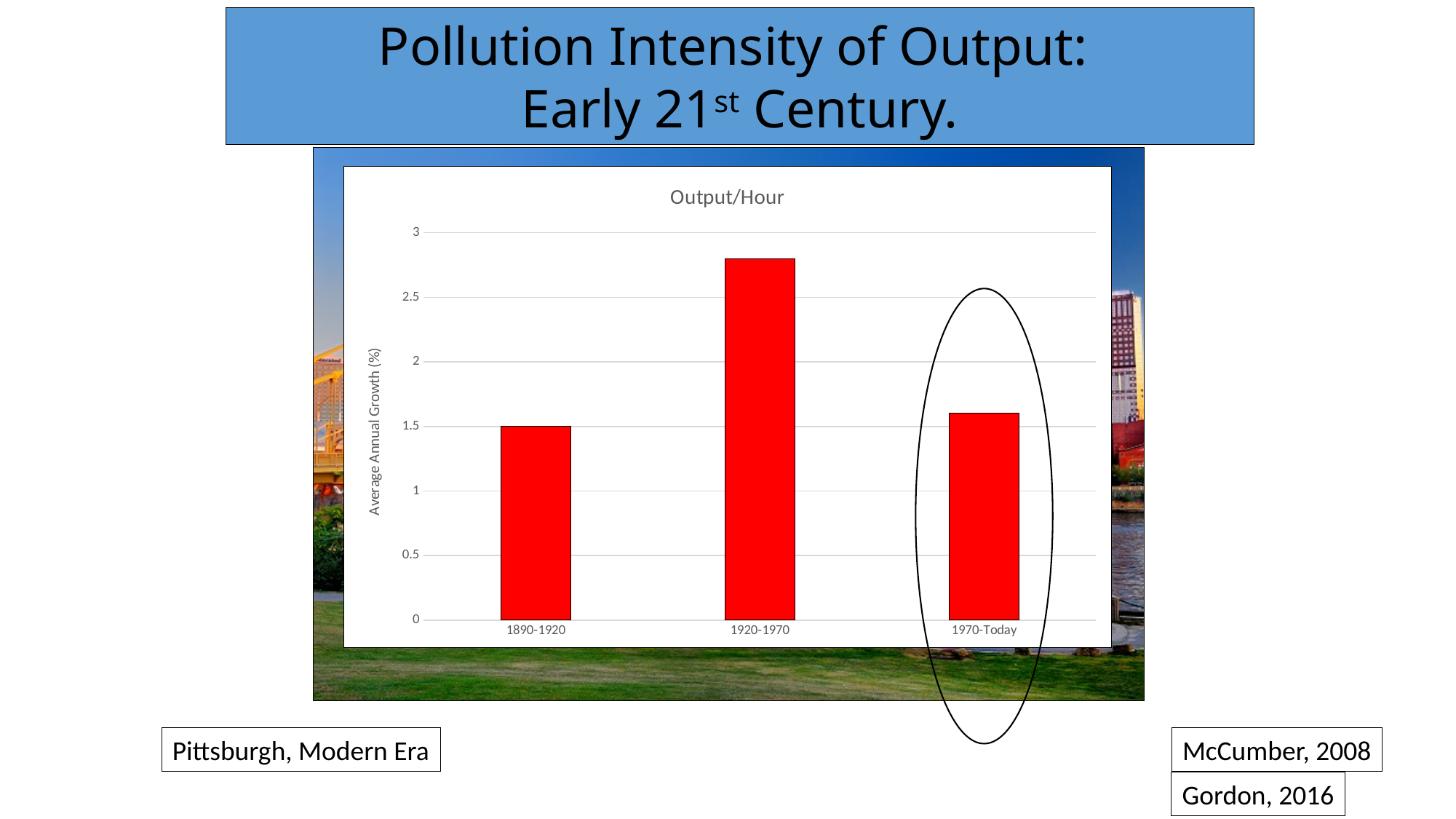
What is the title of the chart? Output/Hour What is the label of the vertical axis? Average Annual Growth (%) Is the value for 1890-1920 greater or less than 2? less What is the average annual growth (%) for 1890-1920? 1.5 Which bar is circled on the chart? 1970-Today What type of chart is shown on the slide? bar chart Is the value for 1920-1970 greater or less than 2.5? greater Which is larger, the value for 1920-1970 or the value for 1970-Today? 1920-1970 How many time periods (bars) are shown in the chart? 3 Which time period has the highest average annual growth? 1920-1970 Does the average annual growth rise or fall from 1920-1970 to 1970-Today? fall Is the value for 1970-Today greater or less than 2? less